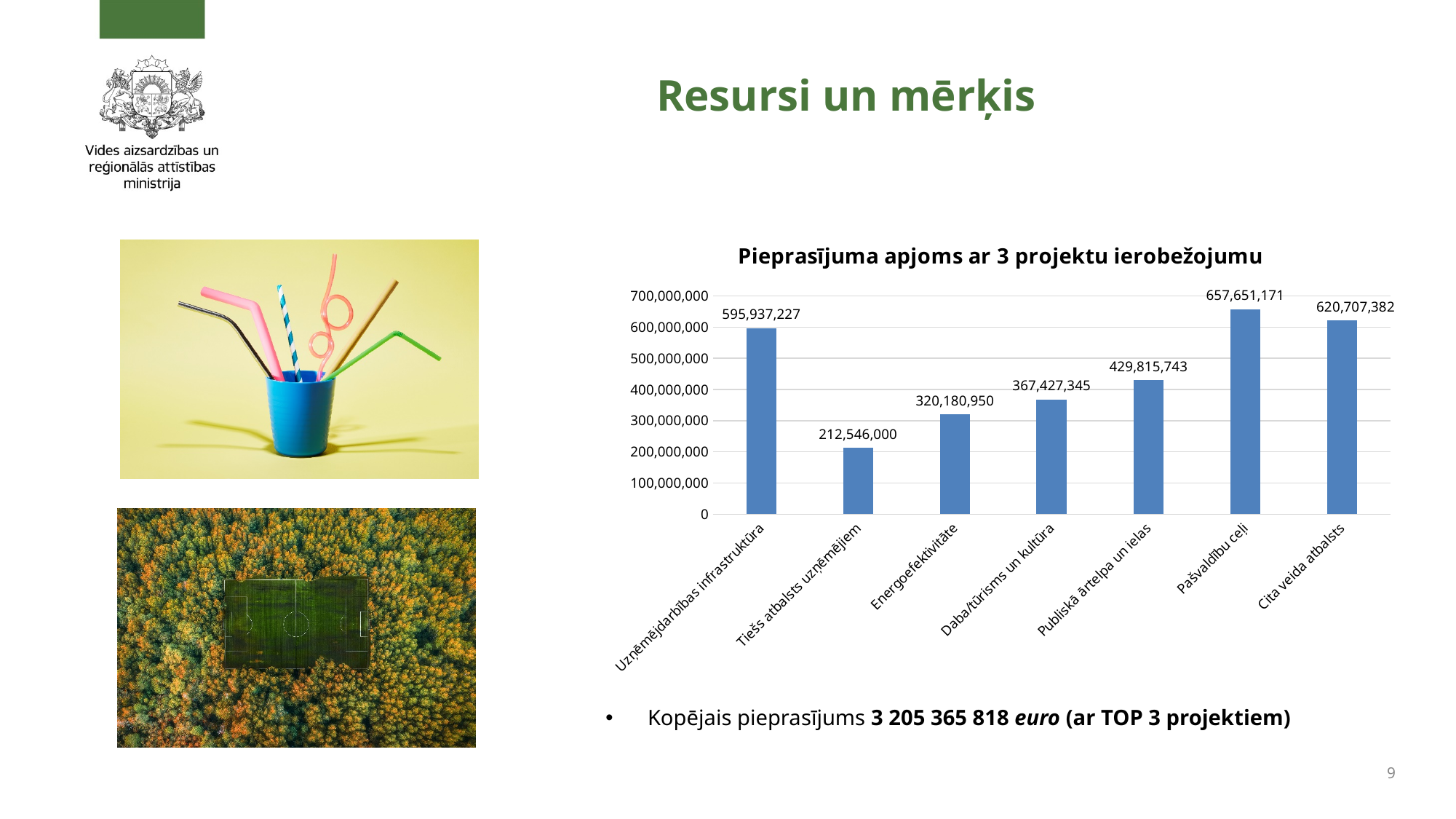
What type of chart is shown on the slide? bar chart Is the value for Daba/tūrisms un kultūra greater or less than 400,000,000? less What is the difference between the values for Pašvaldību ceļi and Cita veida atbalsts? 36,943,789 What is the value for Pašvaldību ceļi? 657,651,171 What is the value for Energoefektivitāte? 320,180,950 Which category has the highest value? Pašvaldību ceļi What is the value for Tiešs atbalsts uzņēmējiem? 212,546,000 Which category has the lowest value? Tiešs atbalsts uzņēmējiem How many categories are shown in the chart? 7 What is the value for Publiskā ārtelpa un ielas? 429,815,743 Which is larger, the value for Uzņēmējdarbības infrastruktūra or the value for Cita veida atbalsts? Cita veida atbalsts What is the difference between the values for Publiskā ārtelpa un ielas and Daba/tūrisms un kultūra? 62,388,398